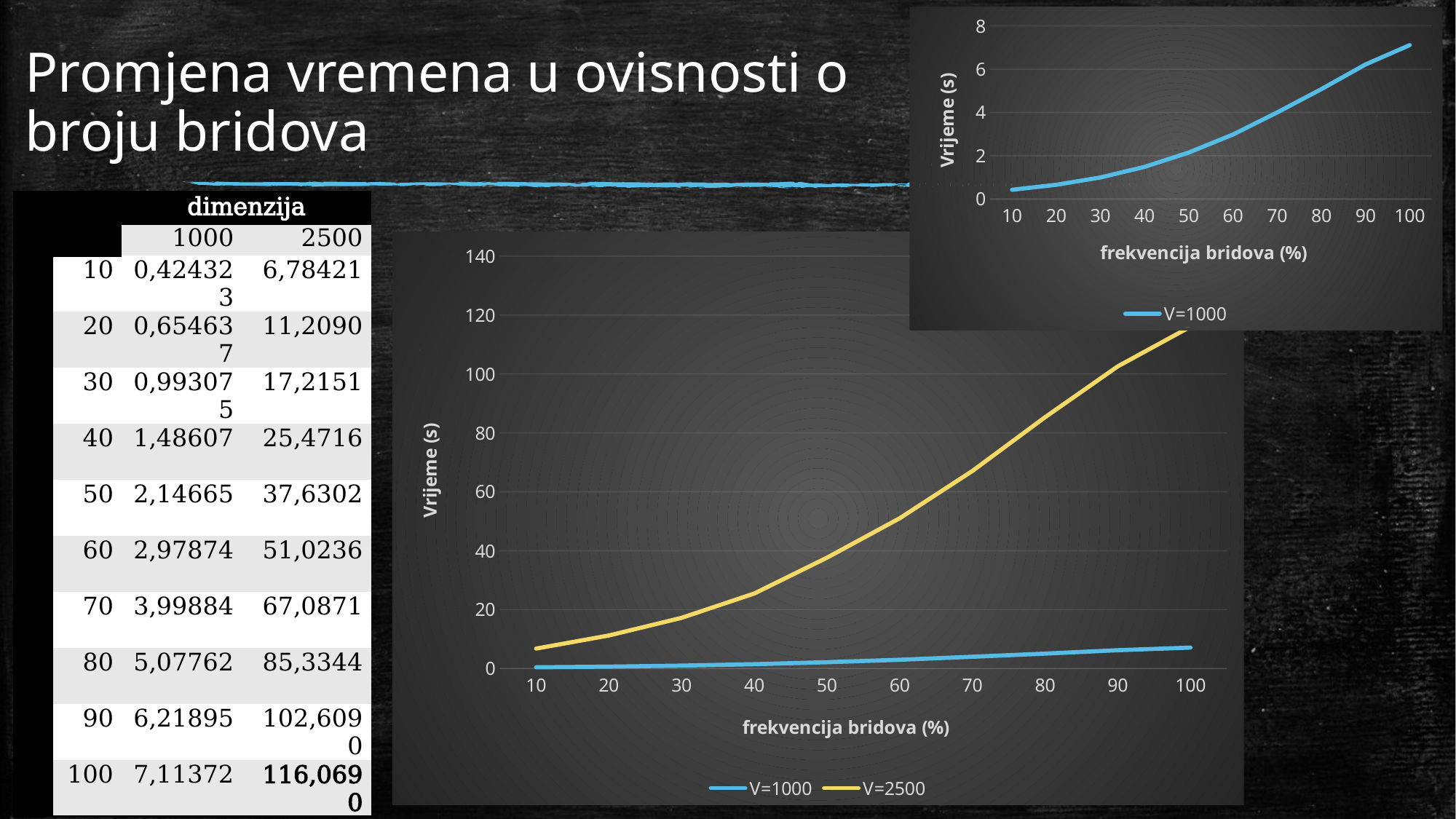
How many series does the legend of the large centre chart list? 2 What kind of chart is the large chart in the centre of the slide? line chart On the large centre chart, at which frequency does the V=2500 series reach its highest value? 100 What is the title of the x axis on the large centre chart? frekvencija bridova (%) On the large centre chart, at which frequency is the V=2500 series lowest? 10 On the small top-right chart, is the V=1000 value at frequency 50 greater or less than 4? less On the large centre chart, is the V=2500 value at frequency 40 greater or less than 40? less On the large centre chart, is the V=2500 value at frequency 100 greater or less than 100? greater On the large centre chart, does the V=2500 series rise or fall as the frequency increases from 10 to 100? rises On the large centre chart, which series has the larger value at frequency 100, V=1000 or V=2500? V=2500 How many x-axis points (frequency values) are plotted on the large centre chart? 10 How many series does the legend of the small chart in the top right list? 1